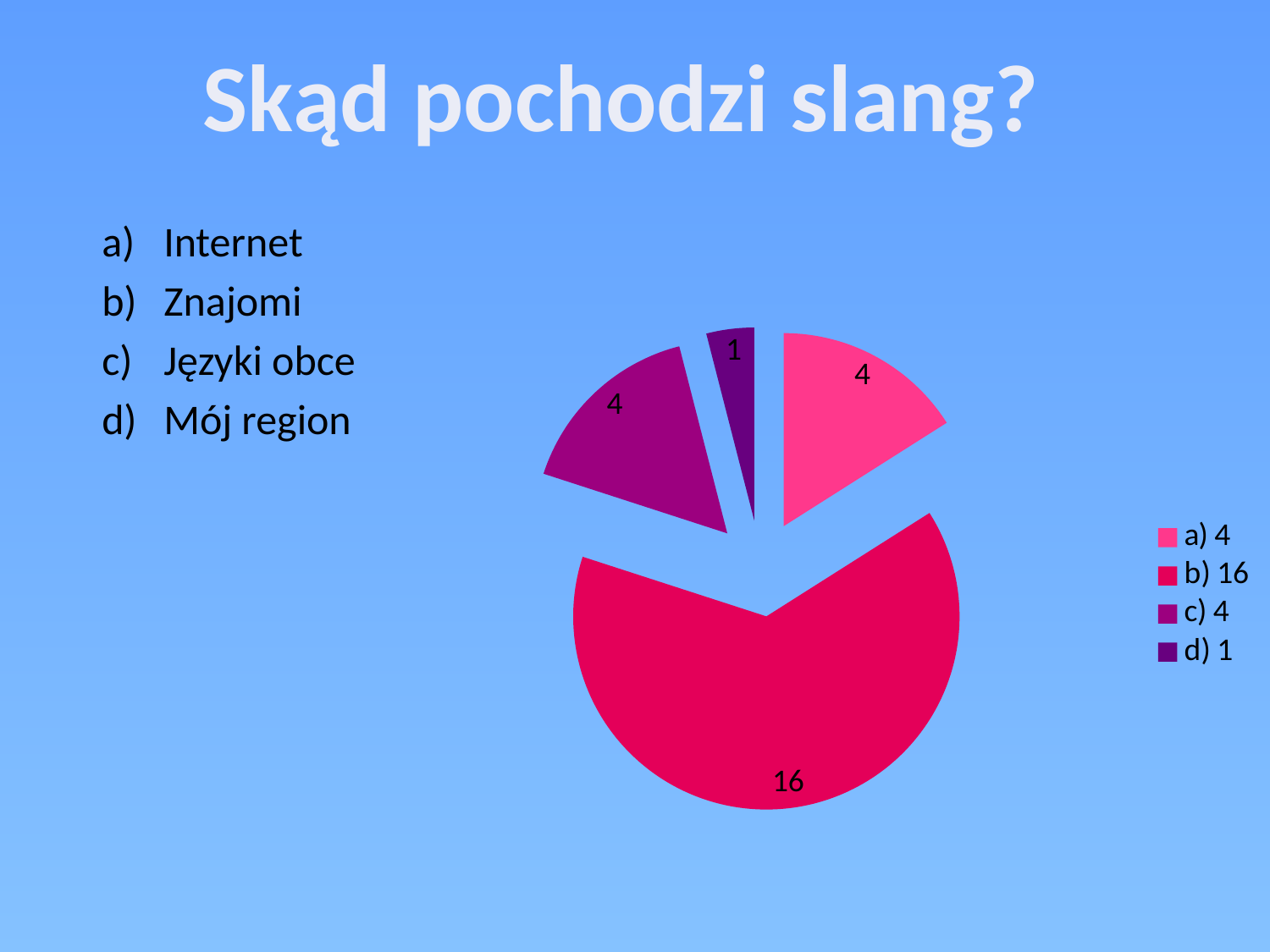
What is the value of the slice labelled "d) 1" in the pie chart? 1 What is the value of the slice labelled "a) 4" in the pie chart? 4 How many slices does the pie chart have? 4 Which slice of the pie chart is the smallest? d) 1 Which slice of the pie chart is the largest? b) 16 How many entries does the legend of the pie chart list? 4 What kind of chart is shown on the slide? pie chart What share of the pie chart does slice b) represent? 64% What is the title of the slide containing the pie chart? Skąd pochodzi slang? What is the value of the slice labelled "b) 16" in the pie chart? 16 What is the difference between the value of slice b) and the value of slice d) in the pie chart? 15 Which is larger in the pie chart, the value of slice b) or the value of slice c)? b)